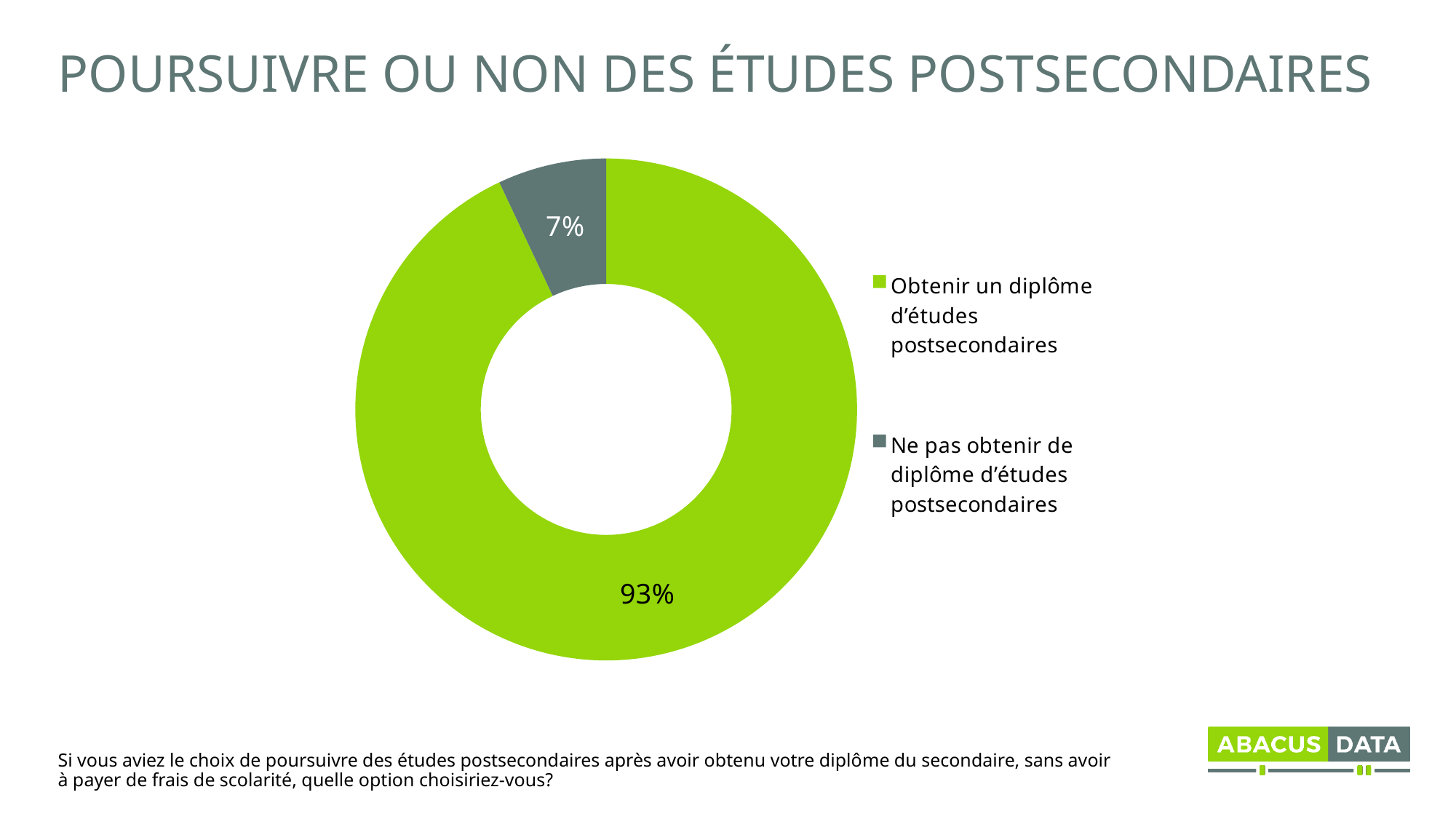
How many categories are shown in the chart? 2 Which is larger: the share for "Obtenir un diplôme d'études postsecondaires" or for "Ne pas obtenir de diplôme d'études postsecondaires"? Obtenir un diplôme d'études postsecondaires Which category has the largest share of the chart? Obtenir un diplôme d'études postsecondaires What is the difference in percentage points between the two categories shown? 86 What percentage of respondents chose "Obtenir un diplôme d'études postsecondaires"? 93% What is the title of the slide? POURSUIVRE OU NON DES ÉTUDES POSTSECONDAIRES What colour is the slice for "Ne pas obtenir de diplôme d'études postsecondaires"? Grey What percentage of respondents chose "Ne pas obtenir de diplôme d'études postsecondaires"? 7% What is the total of the two percentages shown in the chart? 100% What kind of chart is shown on the slide? Doughnut chart Which category has the smallest share of the chart? Ne pas obtenir de diplôme d'études postsecondaires